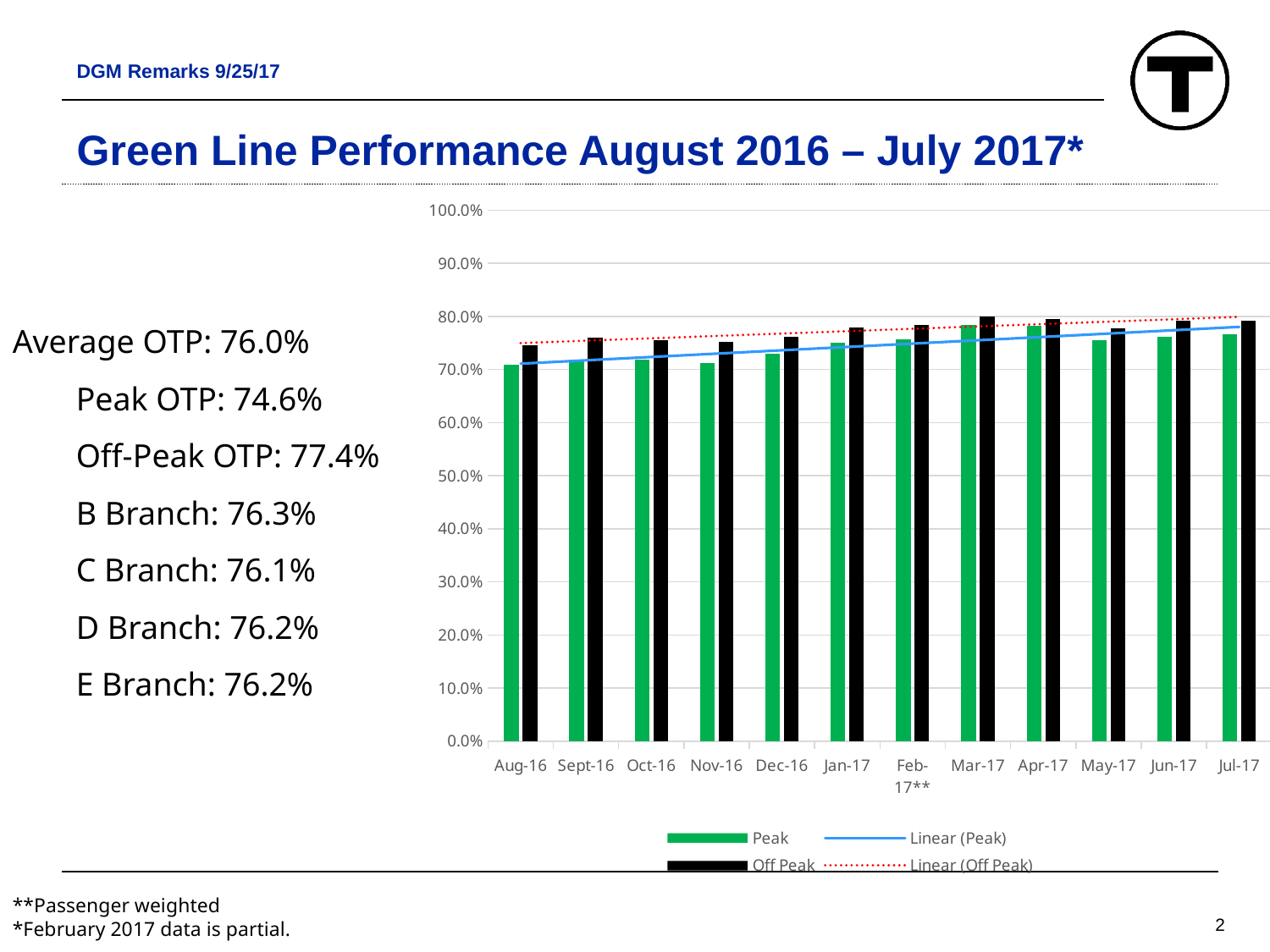
What kind of chart is shown on the slide? bar chart Is the Off Peak value for Mar-17 greater or less than 70.0%? greater Is the Peak value for Nov-16 greater or less than 60.0%? greater Is the Peak value for Aug-16 greater or less than 80.0%? less How many entries does the chart's legend list? 4 What colour are the Off Peak bars in the chart? black How many months are shown along the x axis of the chart? 12 In Aug-16, which is larger, the Peak value or the Off Peak value? Off Peak Which legend entry is shown as a dotted red line? Linear (Off Peak) Which is larger, the Peak value for Mar-17 or the Peak value for Aug-16? Mar-17 Do the Peak values generally rise or fall from Aug-16 to Jul-17? rise